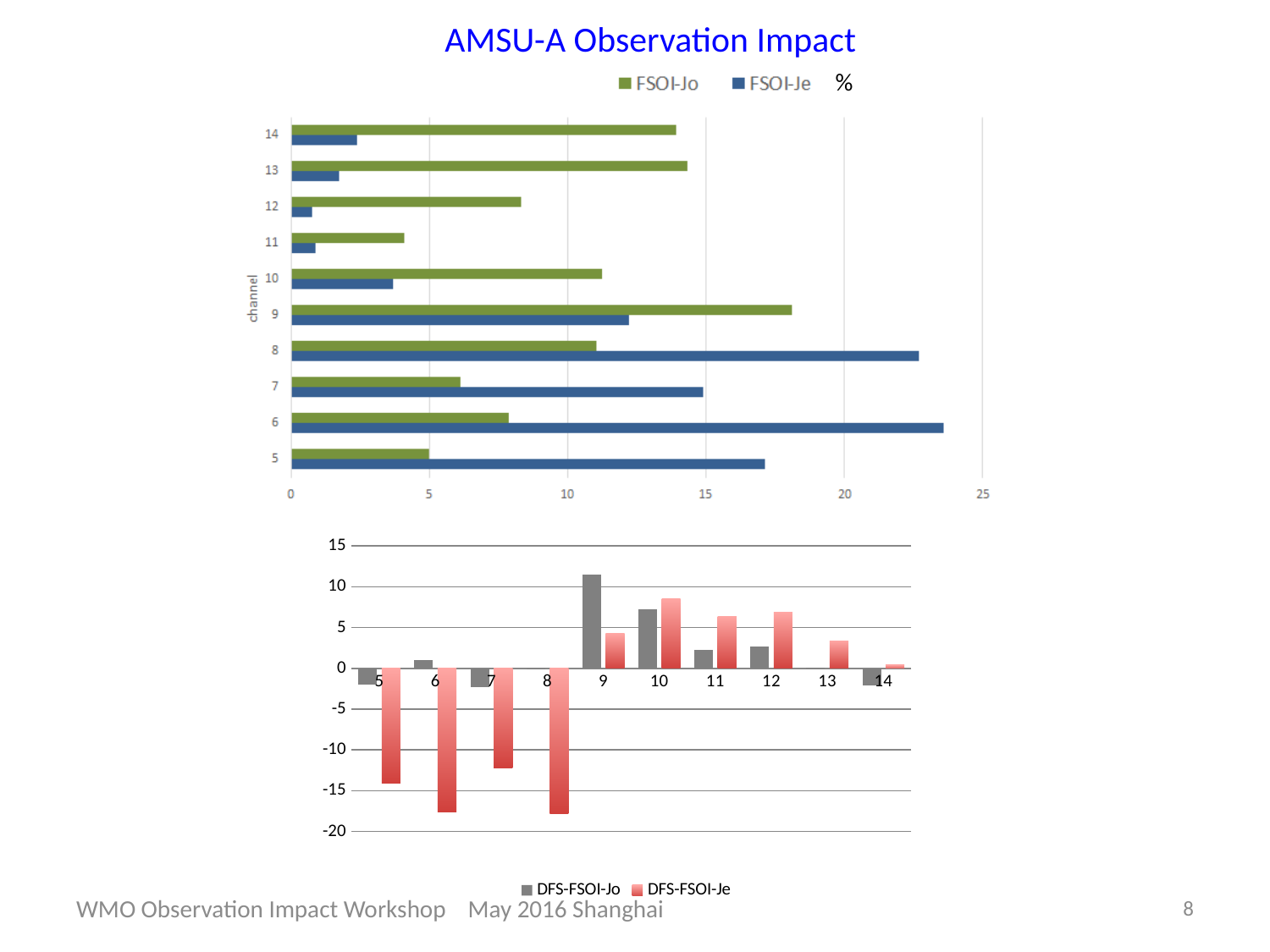
How many series does the legend of the top chart list? 2 What is the label of the vertical axis on the top chart? channel How many channels are shown on the top chart? 10 In the top chart, for channel 13, which series has the larger value, FSOI-Jo or FSOI-Je? FSOI-Jo How many series does the legend of the bottom chart list? 2 In the top chart, is the FSOI-Jo value for channel 12 greater or less than 10? less In the bottom chart, is the DFS-FSOI-Je value for channel 5 greater or less than -10? less What kind of chart is the top chart on the slide? bar chart In the top chart, is the FSOI-Je value for channel 8 greater or less than 20? greater In the bottom chart, which channel has the highest DFS-FSOI-Jo value? 9 In the top chart, for channel 6, which series has the larger value, FSOI-Jo or FSOI-Je? FSOI-Je In the top chart, which channel has the highest FSOI-Jo value? 9